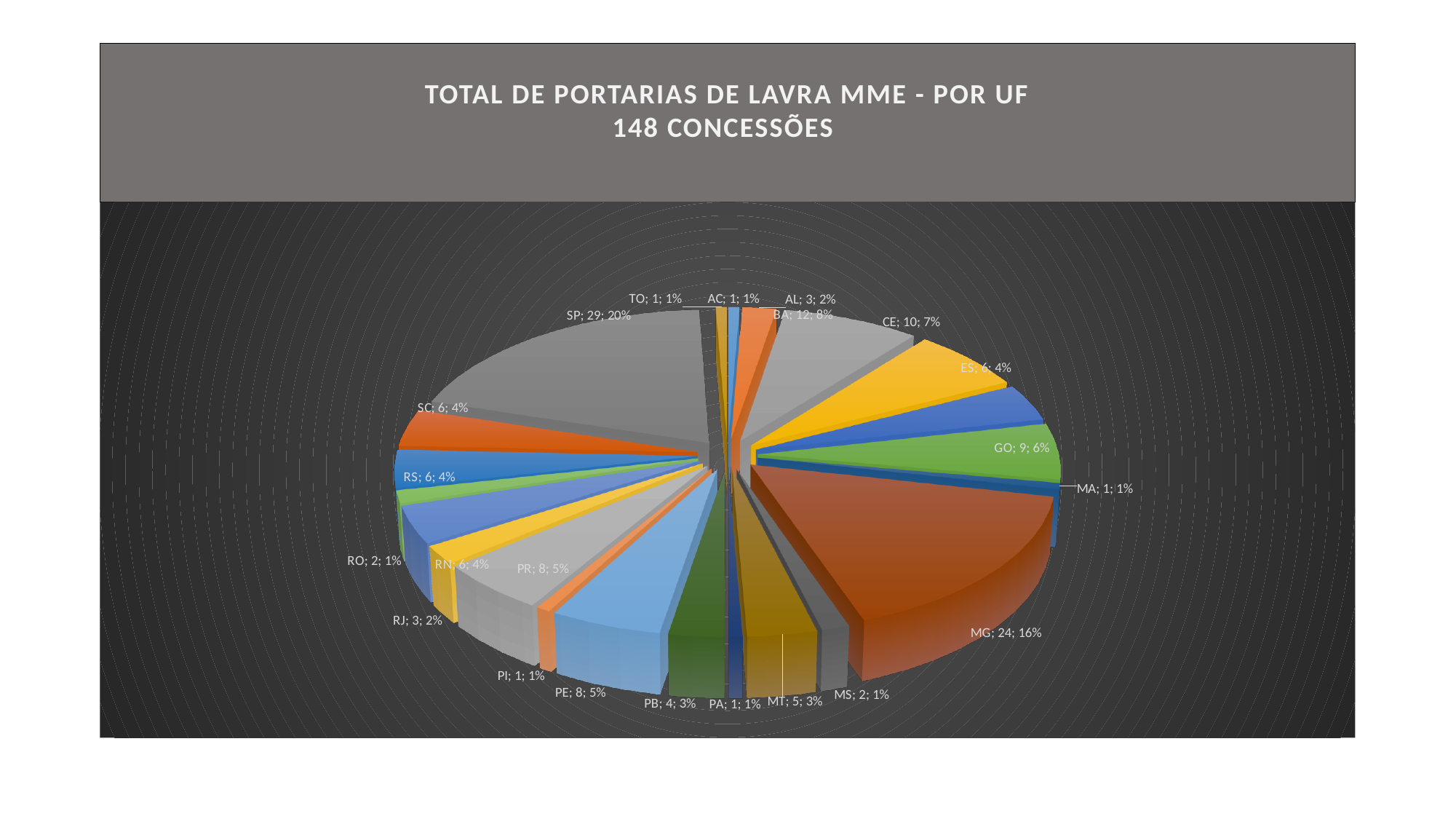
What type of chart is shown on the slide? Pie chart What percentage share does SP have? 20% What is the title of the chart? TOTAL DE PORTARIAS DE LAVRA MME - POR UF 148 CONCESSÕES What is the difference between the values for SP and MG? 5 How many UF categories are shown in the pie chart? 22 Which UF has the highest number of concessions? SP What is the value for SP? 29 What is the difference between the values for BA and CE? 2 Which is larger, the value for CE or the value for GO? CE What is the value for MG? 24 What percentage share does BA have? 8% What is the value for MT? 5